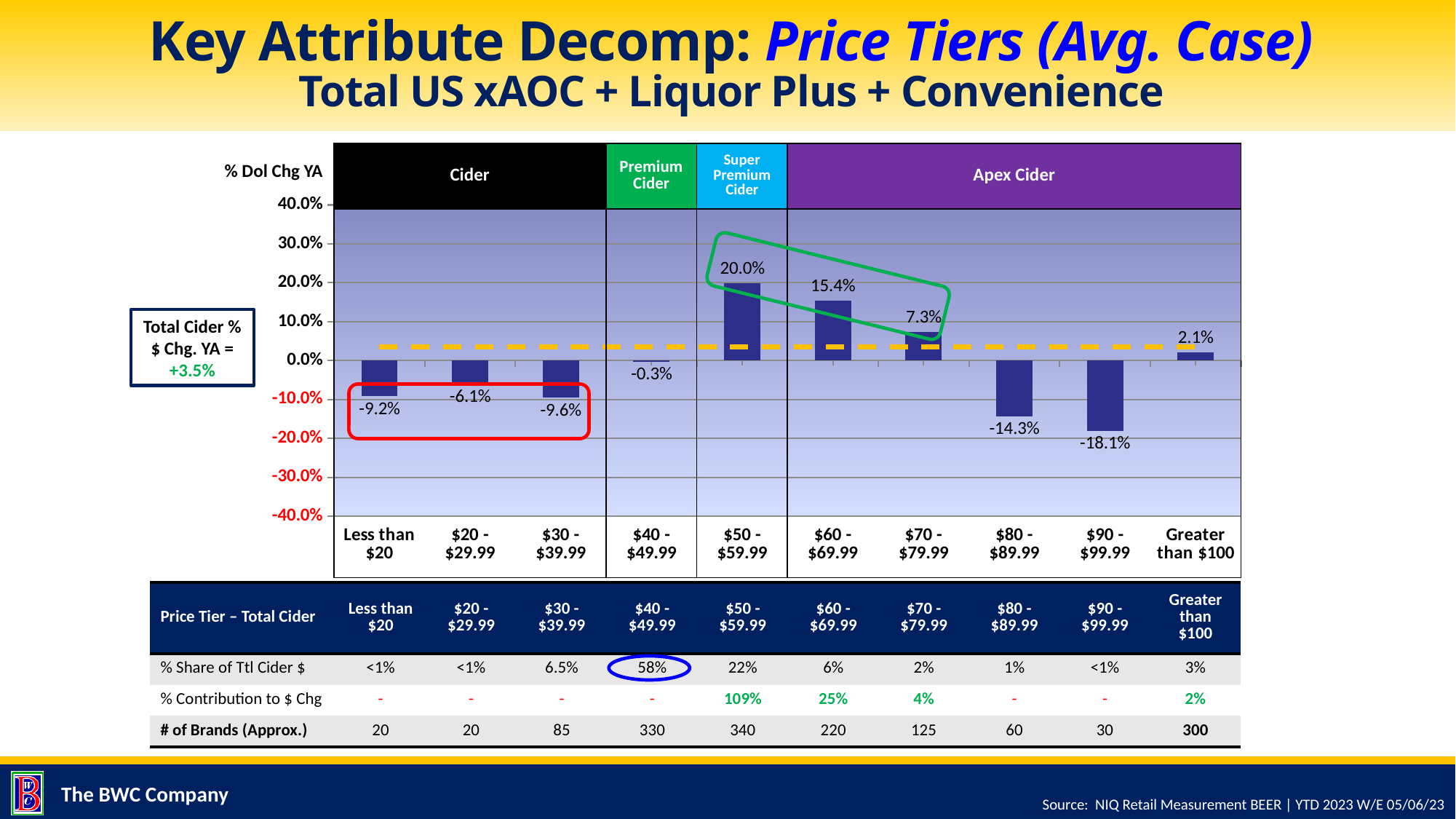
What is the % Dol Chg YA for the $40 - $49.99 price tier? -0.3% What is the % Dol Chg YA for the $50 - $59.99 price tier? 20.0% Which price tier has the lowest % Dol Chg YA? $90 - $99.99 What is the % Dol Chg YA for the $90 - $99.99 price tier? -18.1% What is the difference in % Dol Chg YA between the $50 - $59.99 tier and the $60 - $69.99 tier? 4.6 percentage points Is the value for the $80 - $89.99 tier greater or less than -10.0%? less Which has a larger % Dol Chg YA, the $70 - $79.99 tier or the Greater than $100 tier? $70 - $79.99 What is the Total Cider % $ Chg. YA shown in the callout box? +3.5% What kind of chart is used to show % Dol Chg YA by price tier? Bar chart Which price tier has the highest % Dol Chg YA? $50 - $59.99 Which price tiers fall under the Apex Cider segment header? $60 - $69.99 through Greater than $100 How many price tiers are plotted on the chart? 10